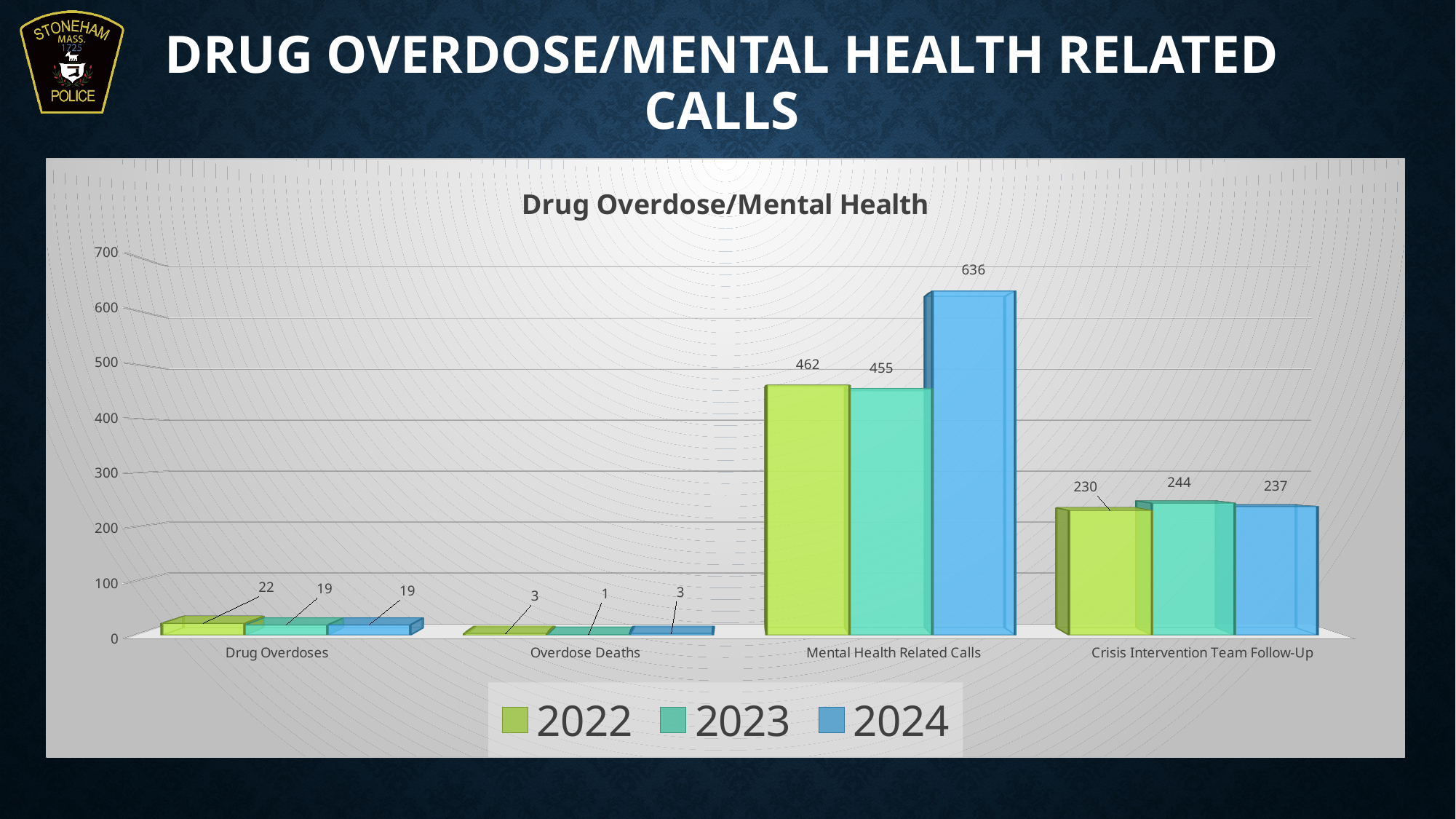
What kind of chart is shown on the slide? Bar chart Which is larger for Crisis Intervention Team Follow-Up: the 2022 value or the 2023 value? 2023 What is the value for Mental Health Related Calls in 2024? 636 What is the value for Drug Overdoses in 2022? 22 How many series does the legend list? 3 What is the difference between the 2024 and 2023 values for Mental Health Related Calls? 181 What is the value for Overdose Deaths in 2023? 1 What is the value for Crisis Intervention Team Follow-Up in 2023? 244 Which category has the highest value in 2024? Mental Health Related Calls Which category has the lowest value in 2022? Overdose Deaths What is the title of the chart? Drug Overdose/Mental Health How many categories are shown on the x axis? 4